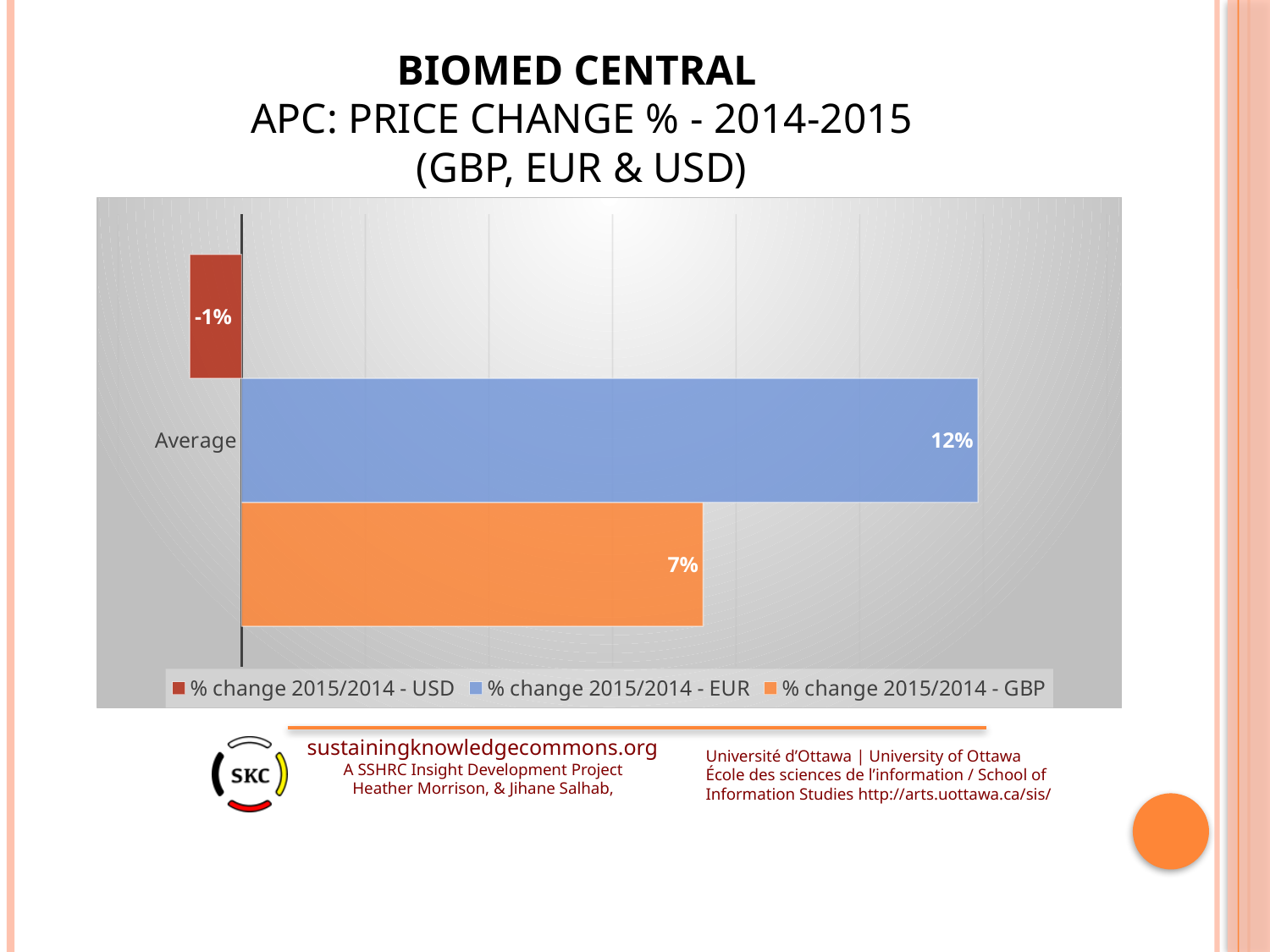
Which is larger for Average: the EUR % change or the GBP % change? % change 2015/2014 - EUR What is the difference between the GBP and USD % change values for Average? 8% How many series does the legend list? 3 What colour is the bar for % change 2015/2014 - GBP? Orange How many categories are shown on the chart? 1 Which series has the highest value for Average? % change 2015/2014 - EUR What kind of chart is shown on the slide? Bar chart What is the % change 2015/2014 - GBP value for Average? 7% What is the % change 2015/2014 - USD value for Average? -1% Which series has the lowest value for Average? % change 2015/2014 - USD What is the difference between the EUR and GBP % change values for Average? 5% What is the % change 2015/2014 - EUR value for Average? 12%